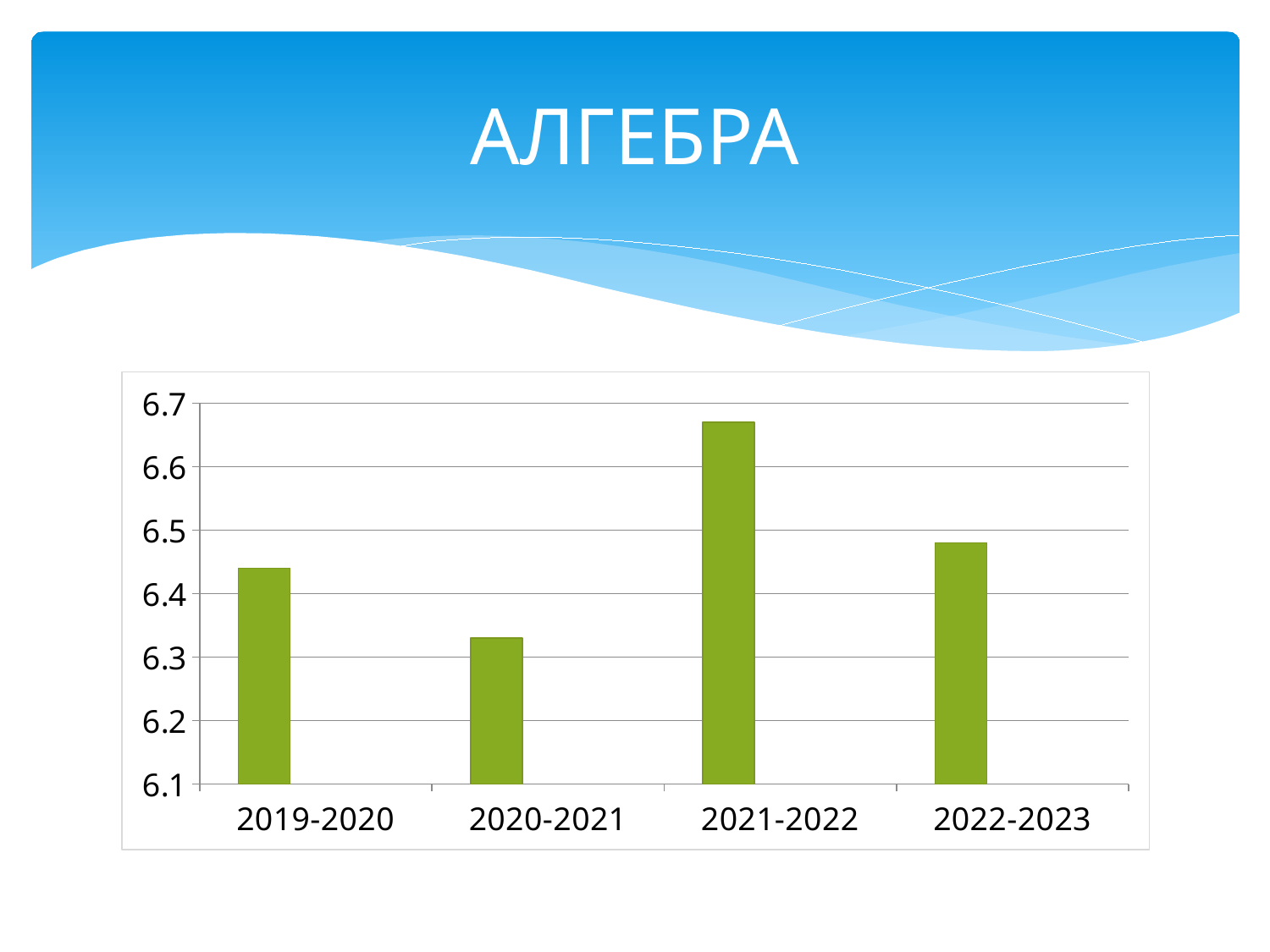
Which school year has the highest bar? 2021-2022 Which is larger, the value for 2022-2023 or the value for 2019-2020? 2022-2023 Which school year has the lowest bar? 2020-2021 What is the title shown at the top of the slide? АЛГЕБРА What kind of chart is shown on the slide? bar chart Does the value rise or fall from 2020-2021 to 2021-2022? rise Is the value for 2019-2020 greater or less than 6.4? greater Is the value for 2021-2022 greater or less than 6.6? greater Which is larger, the value for 2021-2022 or the value for 2020-2021? 2021-2022 Is the value for 2020-2021 greater or less than 6.4? less How many categories (school years) are shown on the x axis? 4